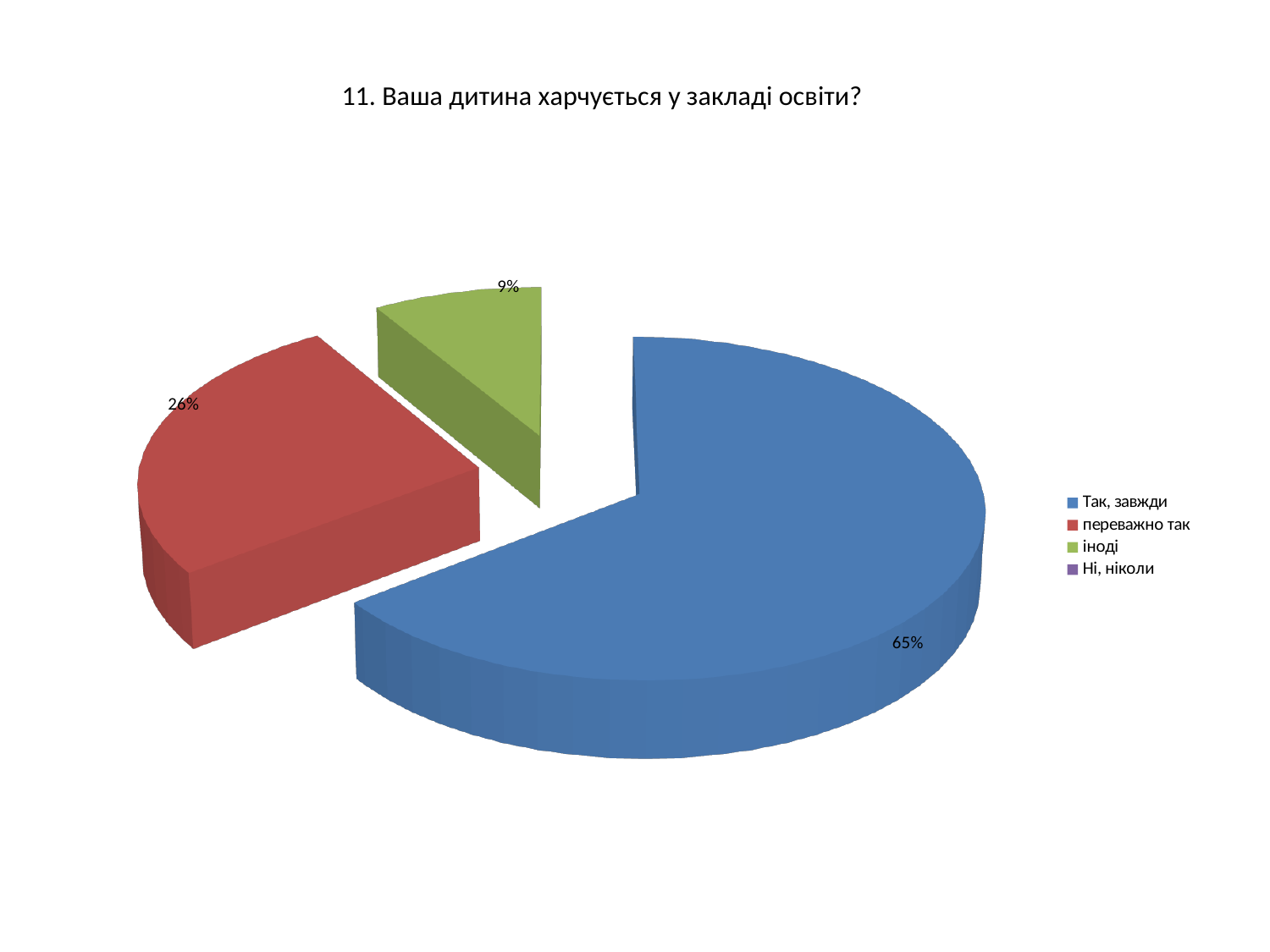
What is the title of the chart? 11. Ваша дитина харчується у закладі освіти? What colour is the slice for "Так, завжди"? blue Which is larger, the slice for "переважно так" or the slice for "іноді"? переважно так Which category has the largest slice of the pie? Так, завжди What share of the pie is labelled for "іноді"? 9% Which of the visible slices is the smallest? іноді What kind of chart is shown on the slide? pie chart What is the difference in percentage points between "Так, завжди" and "переважно так"? 39 What share of the pie is labelled for "Так, завжди"? 65% What is the difference in percentage points between "переважно так" and "іноді"? 17 How many entries does the legend list? 4 What share of the pie is labelled for "переважно так"? 26%